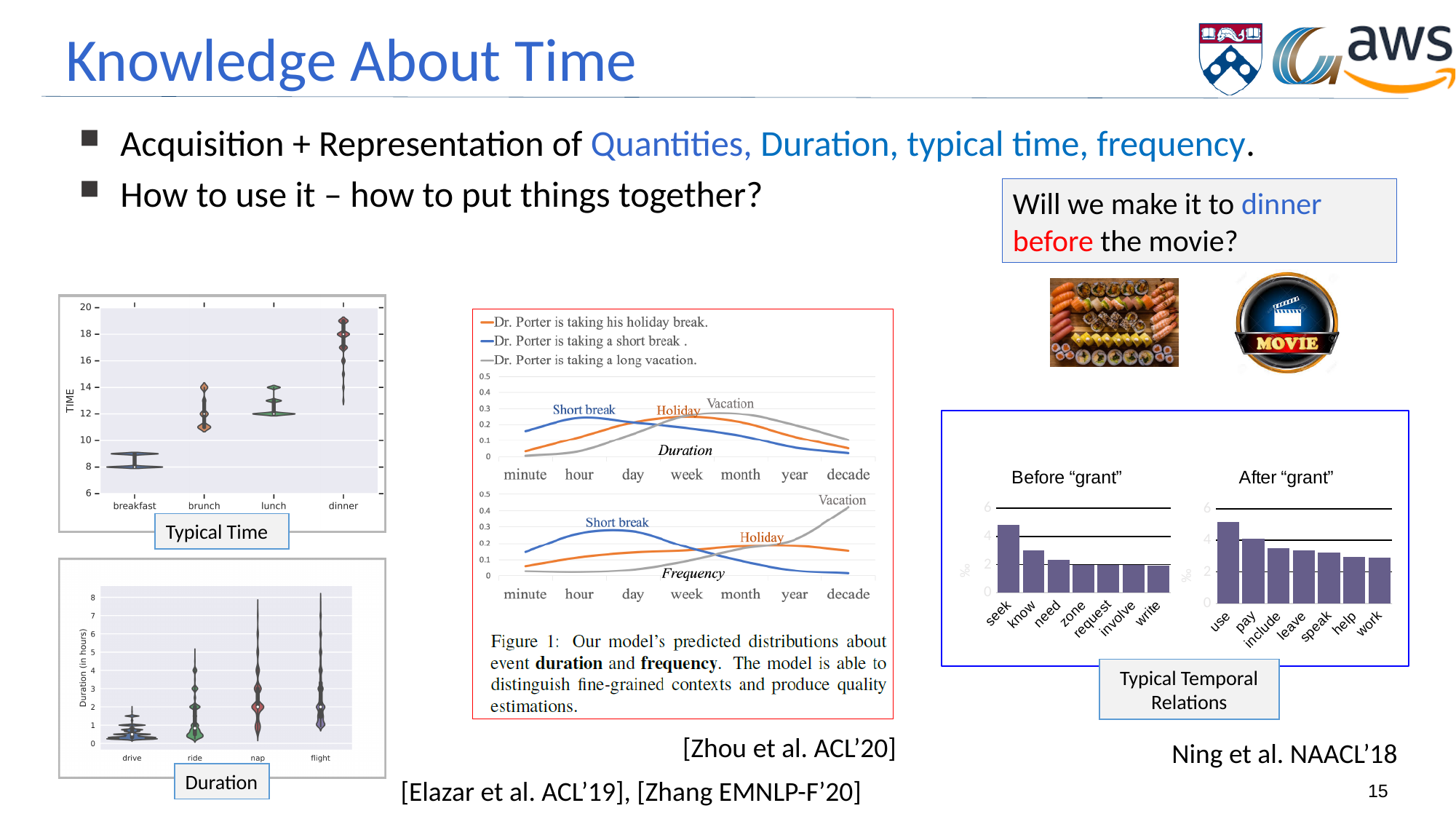
In the Typical Time chart, which category has the lowest typical time? breakfast In the Typical Time chart, which category has the highest typical time? dinner In the Duration chart (bottom left), which category has the lowest duration? drive What kind of chart is the After "grant" chart? bar chart In the line chart from Zhou et al., how many series does the legend list? 3 In the After "grant" chart, how many bars are shown? 7 In the Typical Time chart, how many categories are shown on the x axis? 4 In the Before "grant" chart, which word has the highest bar? seek In the Typical Time chart, is the typical time for breakfast greater or less than 10? less In the Before "grant" chart, is the value for seek greater or less than 4? greater In the Duration chart (bottom left), how many categories are shown on the x axis? 4 In the Frequency line chart, which series has the highest value at 'decade'? Vacation